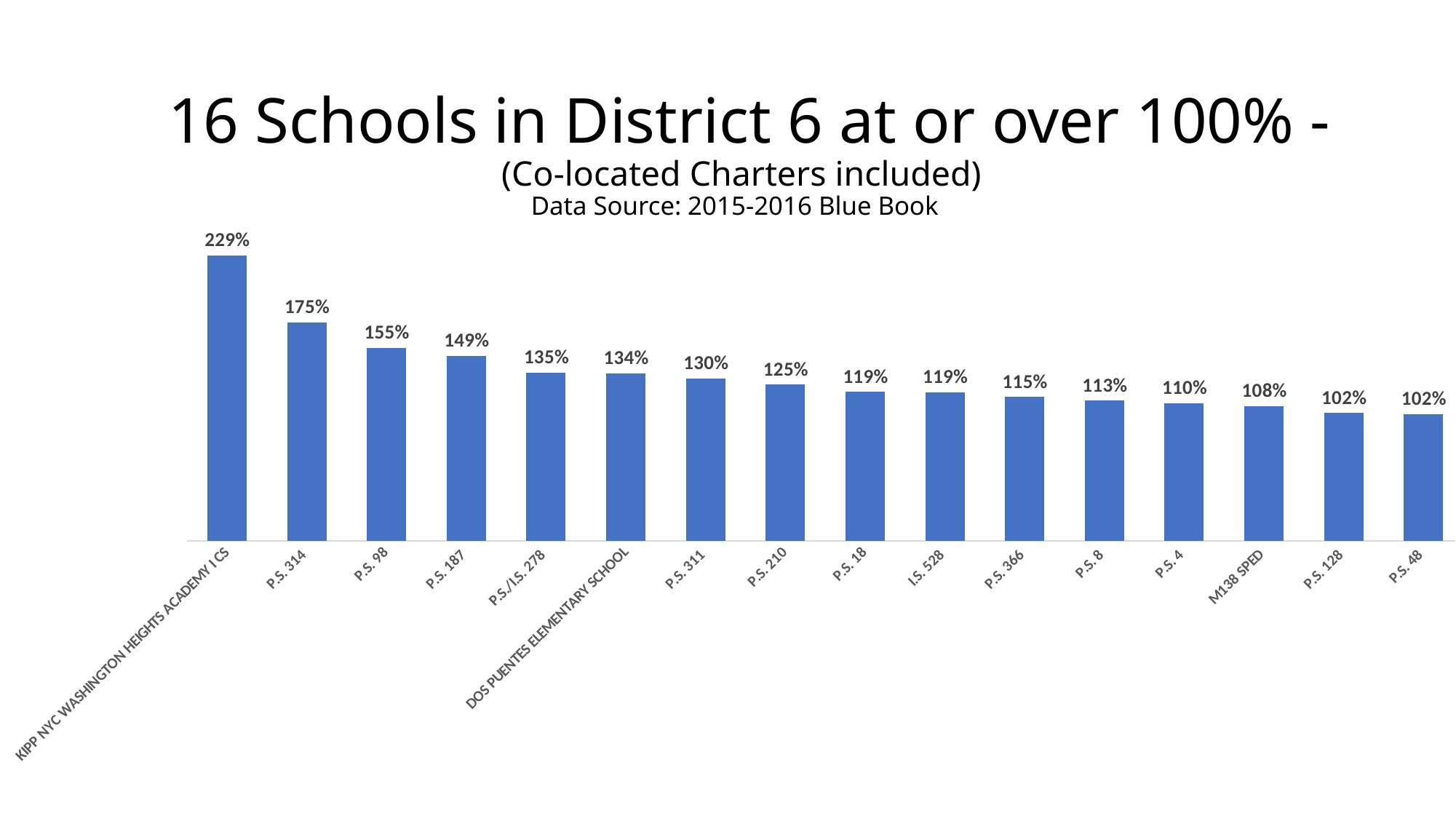
Do the values rise or fall from left to right along the x axis? Fall Which school has the highest value? KIPP NYC WASHINGTON HEIGHTS ACADEMY I CS Which is larger, the value for P.S. 311 or the value for P.S. 210? P.S. 311 What is the value for M138 SPED? 108% How many schools are shown in the chart? 16 What is the value for P.S. 187? 149% What is the value for DOS PUENTES ELEMENTARY SCHOOL? 134% What is the difference between the values for P.S. 98 and P.S. 187? 6% What is the value for P.S. 314? 175% What data source is cited on the slide? 2015-2016 Blue Book What kind of chart is shown on the slide? Bar chart What is the difference between the values for KIPP NYC WASHINGTON HEIGHTS ACADEMY I CS and P.S. 314? 54%